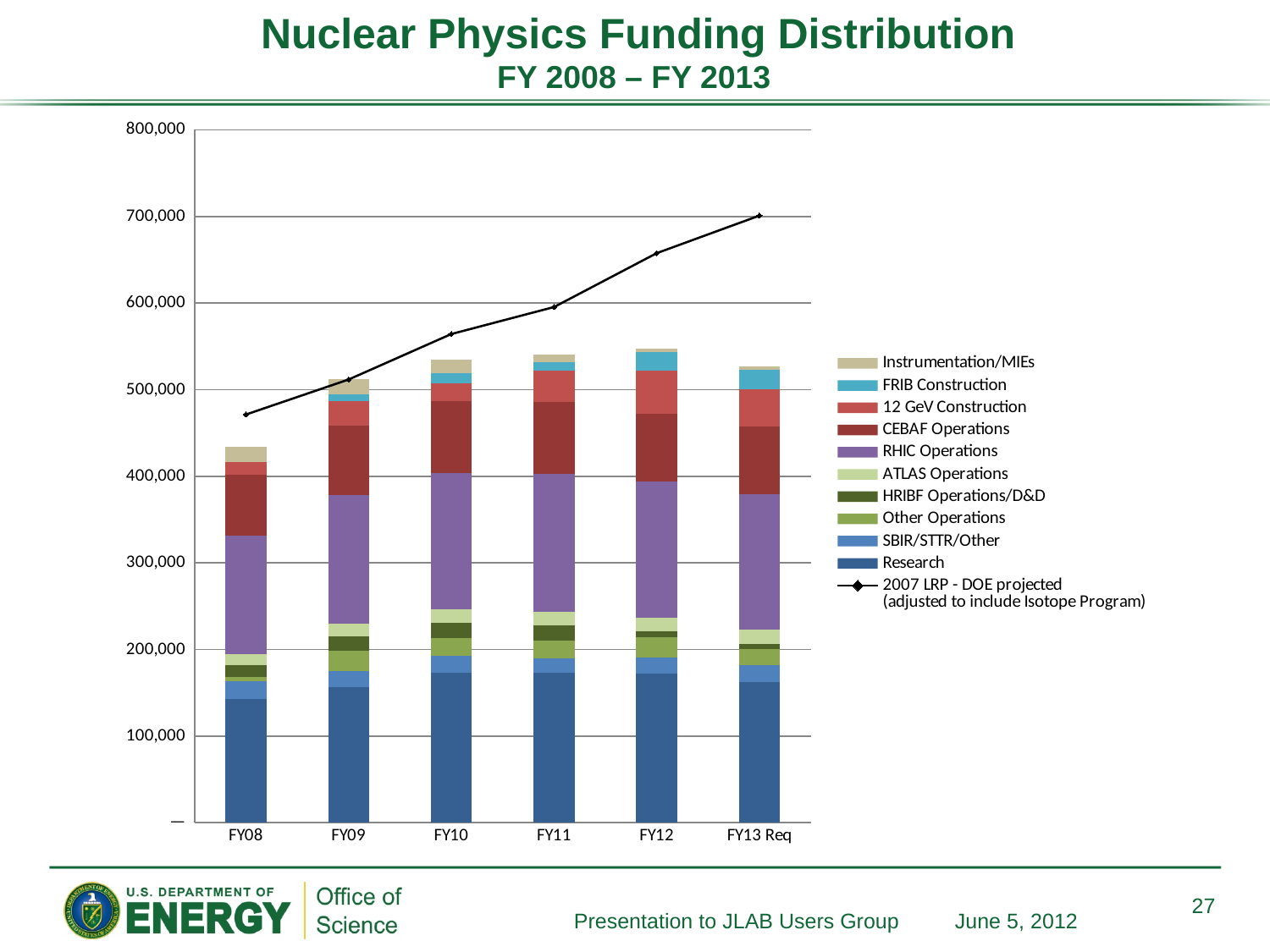
What kind of chart is shown on the slide? Stacked bar chart with a line overlay How many fiscal-year categories are shown on the x axis? 6 Does the 2007 LRP - DOE projected line rise or fall from FY08 to FY13 Req? rise Is the 2007 LRP - DOE projected line value for FY08 greater or less than 500,000? less Which series forms the bottom segment of each stacked bar? Research Which has the larger total stacked bar, FY08 or FY09? FY09 Is the total stacked bar for FY12 greater or less than 500,000? greater Is the total stacked bar for FY08 greater or less than 500,000? less Which fiscal year has the lowest total stacked bar? FY08 What is the title of the chart on the slide? Nuclear Physics Funding Distribution FY 2008 – FY 2013 How many entries does the legend list? 11